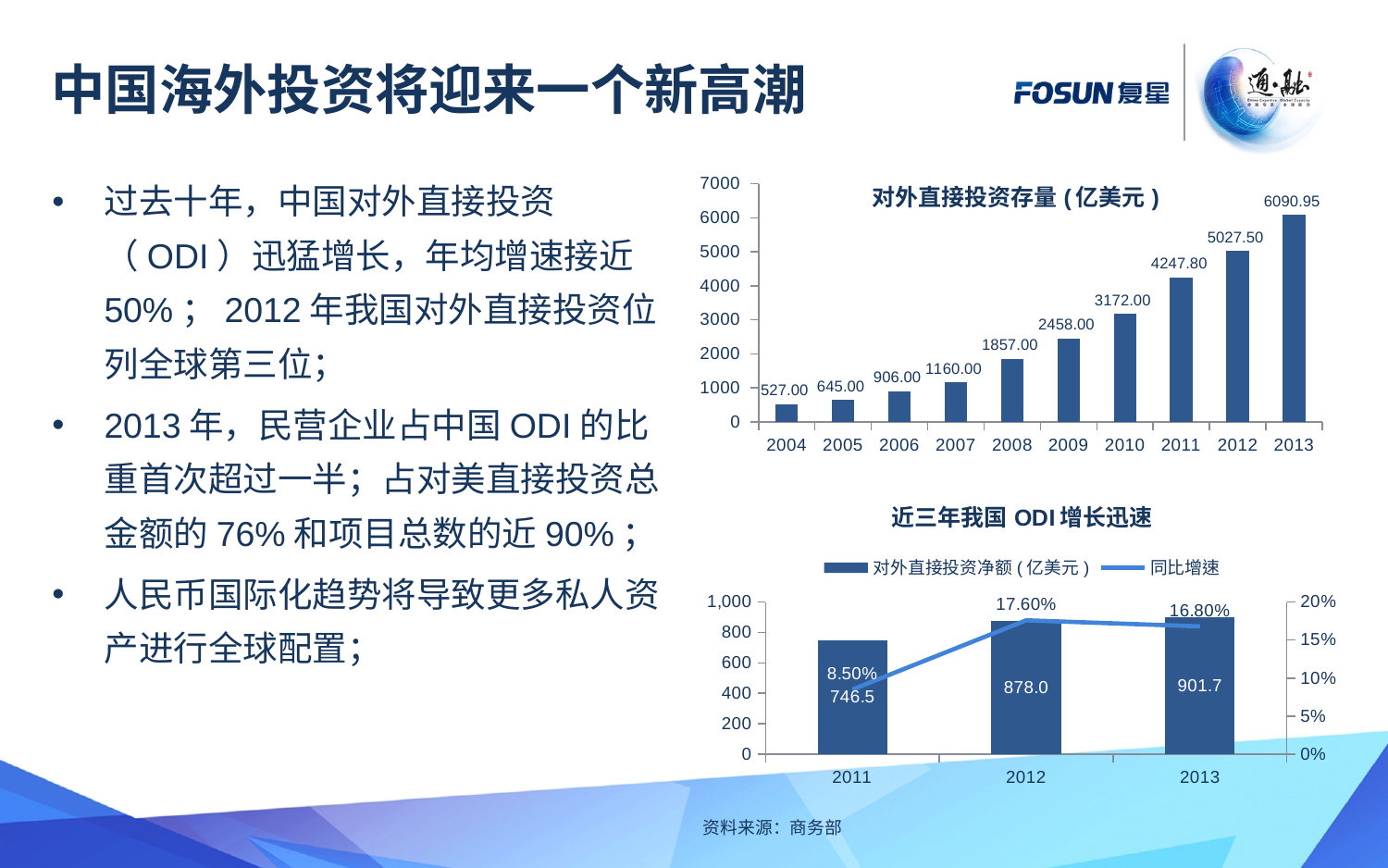
In the bottom chart titled 近三年我国ODI增长迅速, what is the 对外直接投资净额 value for 2012? 878.0 In the top chart titled 对外直接投资存量(亿美元), is the value for 2010 greater or less than 3000? greater In the bottom chart titled 近三年我国ODI增长迅速, how many series does the legend list? 2 In the top chart titled 对外直接投资存量(亿美元), do the values rise or fall from 2004 to 2013? rise In the top chart titled 对外直接投资存量(亿美元), how many years are shown on the x axis? 10 In the bottom chart titled 近三年我国ODI增长迅速, which year has the highest 同比增速? 2012 In the top chart titled 对外直接投资存量(亿美元), what is the value for 2008? 1857.00 In the bottom chart titled 近三年我国ODI增长迅速, what is the difference between the 2013 and 2011 对外直接投资净额 values? 155.2 In the top chart titled 对外直接投资存量(亿美元), what is the value for 2013? 6090.95 In the top chart titled 对外直接投资存量(亿美元), which year has the lowest value? 2004 In the bottom chart titled 近三年我国ODI增长迅速, what is the 同比增速 value for 2011? 8.50% In the top chart titled 对外直接投资存量(亿美元), what is the difference between the 2012 and 2011 values? 779.70